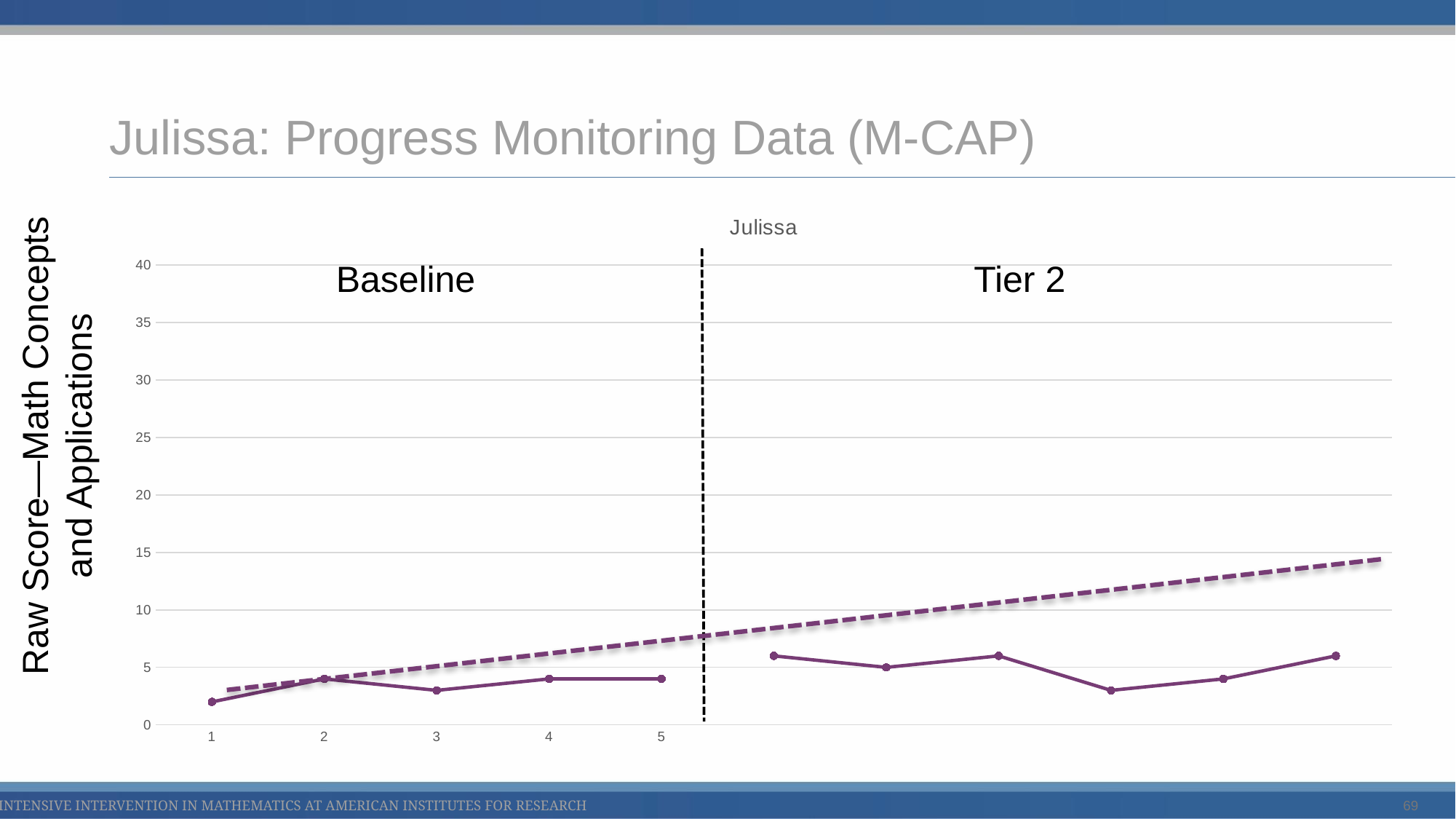
How many data points are plotted in the Tier 2 phase, to the right of the dashed vertical line? 6 Is the value at x = 3 greater or less than 5? less How many data points are plotted in the Baseline phase (the points with x-axis labels 1 to 5)? 5 Does the plotted line rise or fall from x = 1 to x = 2? rises Is the value at x = 5 greater or less than 5? less What are the two phase labels printed inside the chart area? Baseline and Tier 2 Is the value at x = 1 greater or less than 5? less Does the dashed trend line rise or fall from left to right across the chart? rises What is the title printed above the chart? Julissa What kind of chart is shown on the slide? line chart